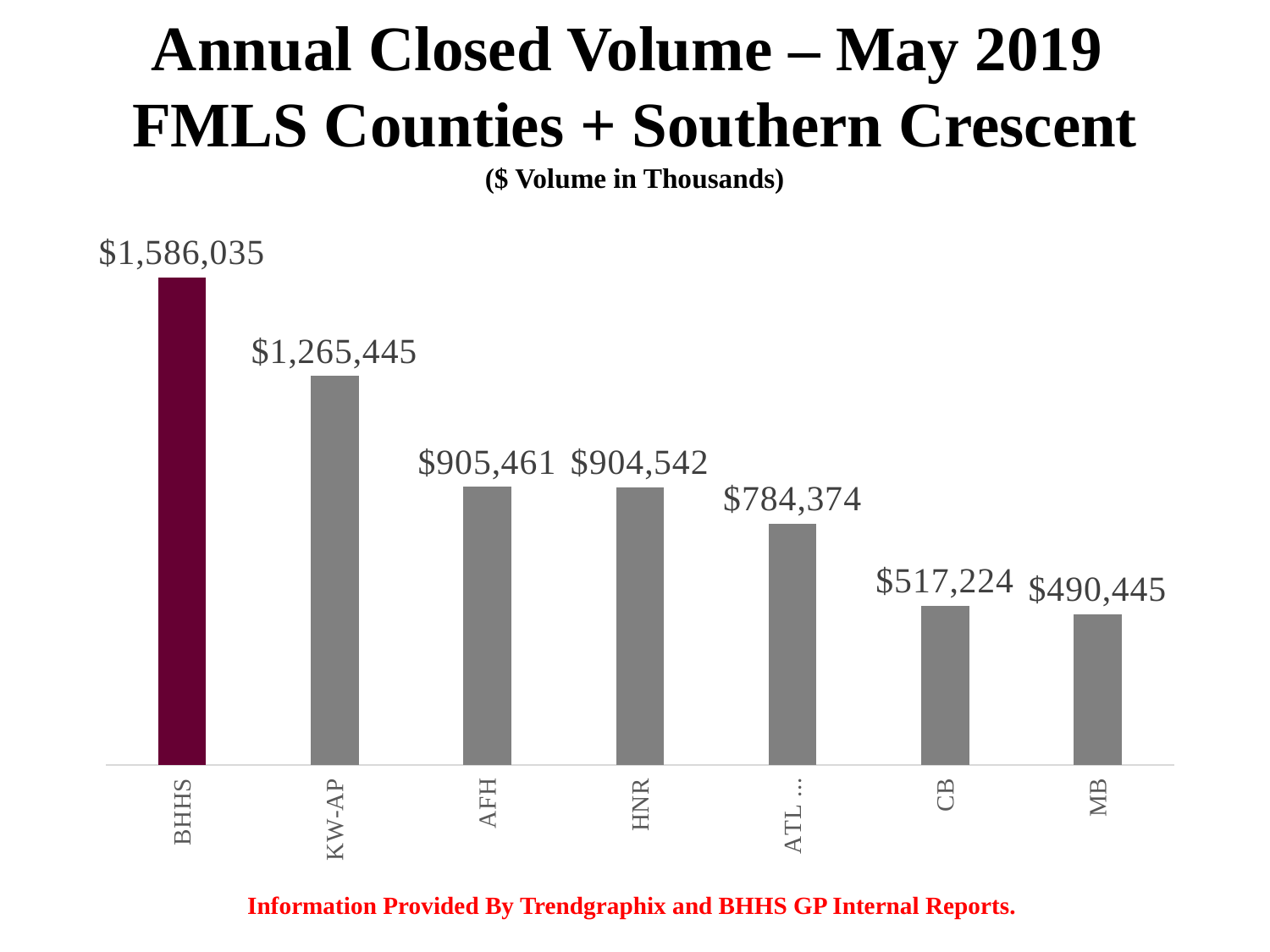
How many companies are shown in the chart? 7 Which has a larger closed volume, KW-AP or AFH? KW-AP Which company has the highest annual closed volume? BHHS Which company has the lowest annual closed volume? MB What is the difference between the closed volume of BHHS and KW-AP? $320,590 What type of chart is shown on the slide? Bar chart What is the annual closed volume for CB? $517,224 What is the difference between the closed volume of AFH and HNR? $919 Which bar is highlighted in a different colour from the others? BHHS What is the annual closed volume for KW-AP? $1,265,445 What is the annual closed volume for BHHS? $1,586,035 What is the annual closed volume for MB? $490,445